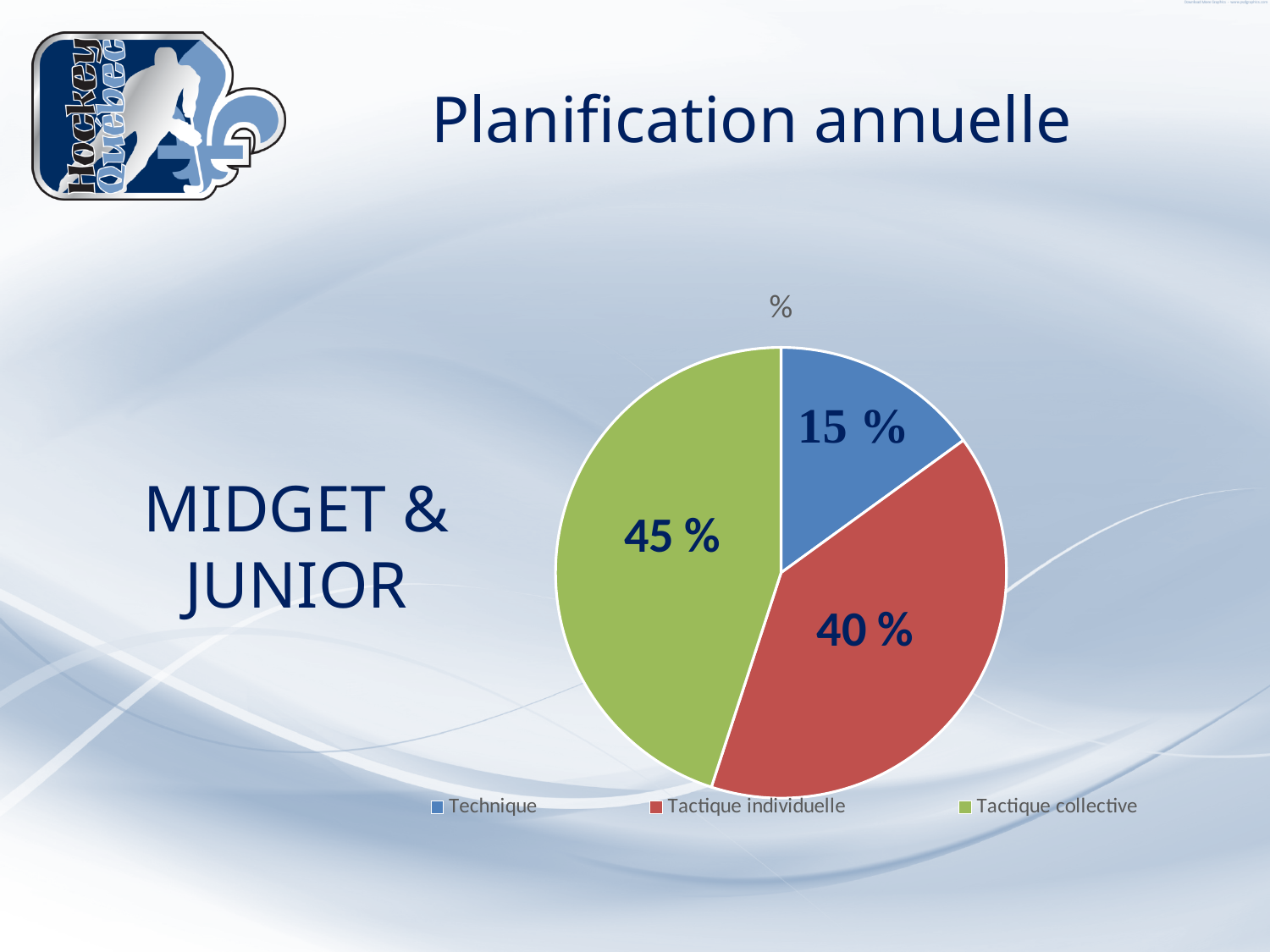
Which category has the smallest slice? Technique What kind of chart is shown on the slide? pie chart What is the value for Tactique collective? 45 % What is the value for Technique? 15 % What colour is the Tactique individuelle slice? red How many slices does the pie chart have? 3 Which is larger, Tactique individuelle or Technique? Tactique individuelle What is the difference between Tactique collective and Technique? 30 % What is the title of the chart? % What is the difference between Tactique collective and Tactique individuelle? 5 % Which category has the largest slice? Tactique collective What is the value for Tactique individuelle? 40 %